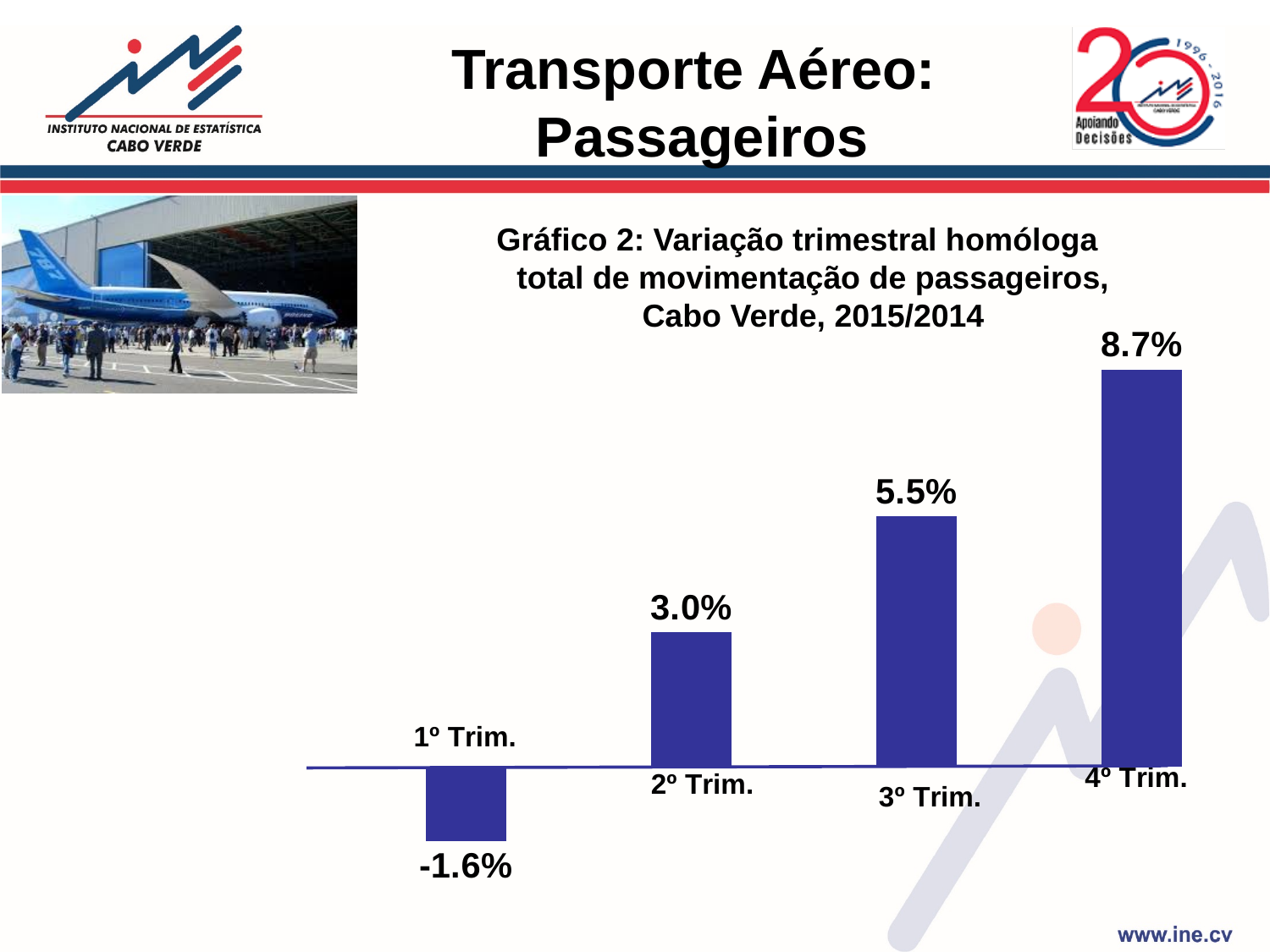
What is the value for 2º Trim.? 3.0% What is the value for 4º Trim.? 8.7% What kind of chart is shown? Bar chart Do the values rise or fall from 1º Trim. to 4º Trim.? Rise Which is larger, the value for 2º Trim. or 3º Trim.? 3º Trim. Which quarter has the highest value? 4º Trim. What is the difference between the values for 4º Trim. and 3º Trim.? 3.2% Which quarter has the lowest value? 1º Trim. What is the value for 1º Trim.? -1.6% How many quarters are shown in the chart? 4 What is the value for 3º Trim.? 5.5% What is the difference between the values for 2º Trim. and 1º Trim.? 4.6%